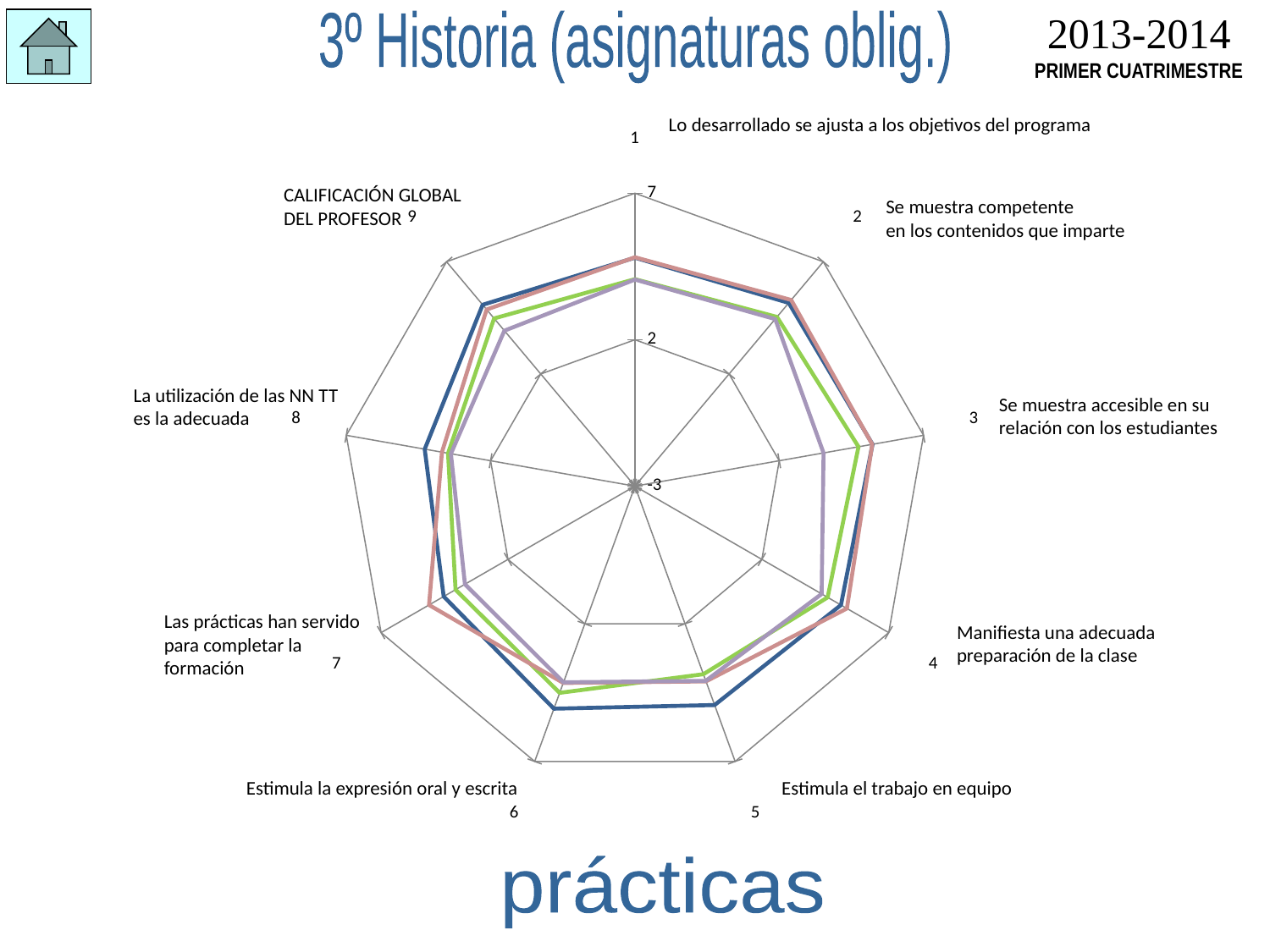
For 'Las prácticas han servido para completar la formación', which line has the larger value, the pink line or the purple line? Pink line Is the value of the blue line for 'Estimula la expresión oral y escrita' greater or less than 7? less What kind of chart is shown on the slide? Radar chart How many data series (lines) are plotted on the radar chart? 4 Is the value of the pink line for 'Se muestra accesible en su relación con los estudiantes' greater or less than 7? less What is the label of category 9 on the radar chart? CALIFICACIÓN GLOBAL DEL PROFESOR Is the value of the purple line for 'Lo desarrollado se ajusta a los objetivos del programa' greater or less than 2? greater How many categories (axes) does the radar chart have? 9 For 'Estimula la expresión oral y escrita', which line has the larger value, the blue line or the purple line? Blue line For 'Se muestra accesible en su relación con los estudiantes', which line has the larger value, the pink line or the purple line? Pink line What is the label of category 1 on the radar chart? Lo desarrollado se ajusta a los objetivos del programa